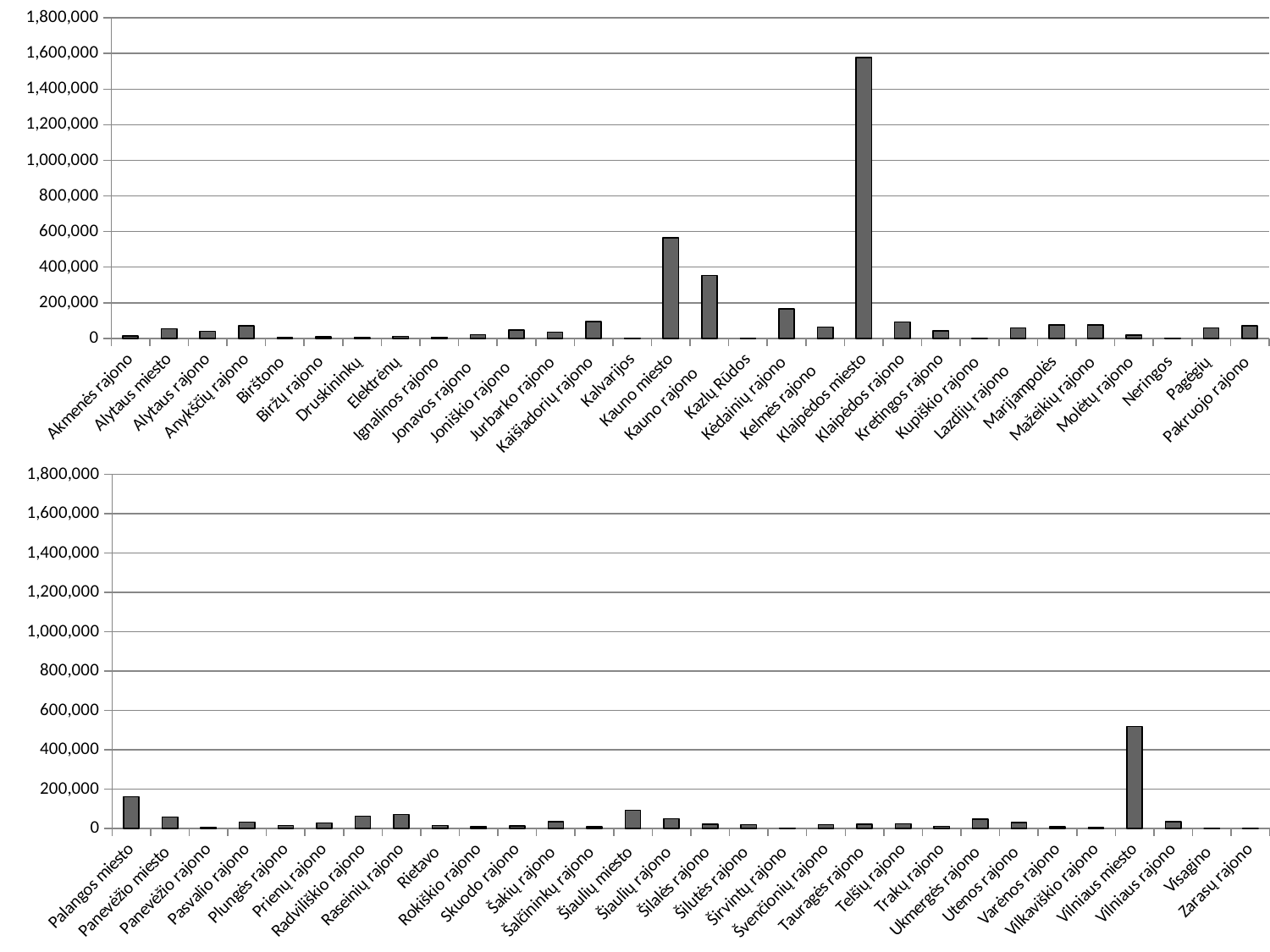
In the top chart, is the value for Kauno miesto greater or less than 400,000? greater In the top chart, which category has the highest value? Klaipėdos miesto How many categories are shown in the top chart? 30 In the bottom chart, is the value for Vilniaus miesto greater or less than 400,000? greater In the top chart, is the value for Klaipėdos miesto greater or less than 1,400,000? greater In the top chart, which is larger, the value for Kauno miesto or Kauno rajono? Kauno miesto In the top chart, which is larger, the value for Kėdainių rajono or Kelmės rajono? Kėdainių rajono What kind of chart is the bottom chart? bar chart In the bottom chart, which category has the highest value? Vilniaus miesto In the bottom chart, which is larger, the value for Palangos miesto or Šiaulių miesto? Palangos miesto